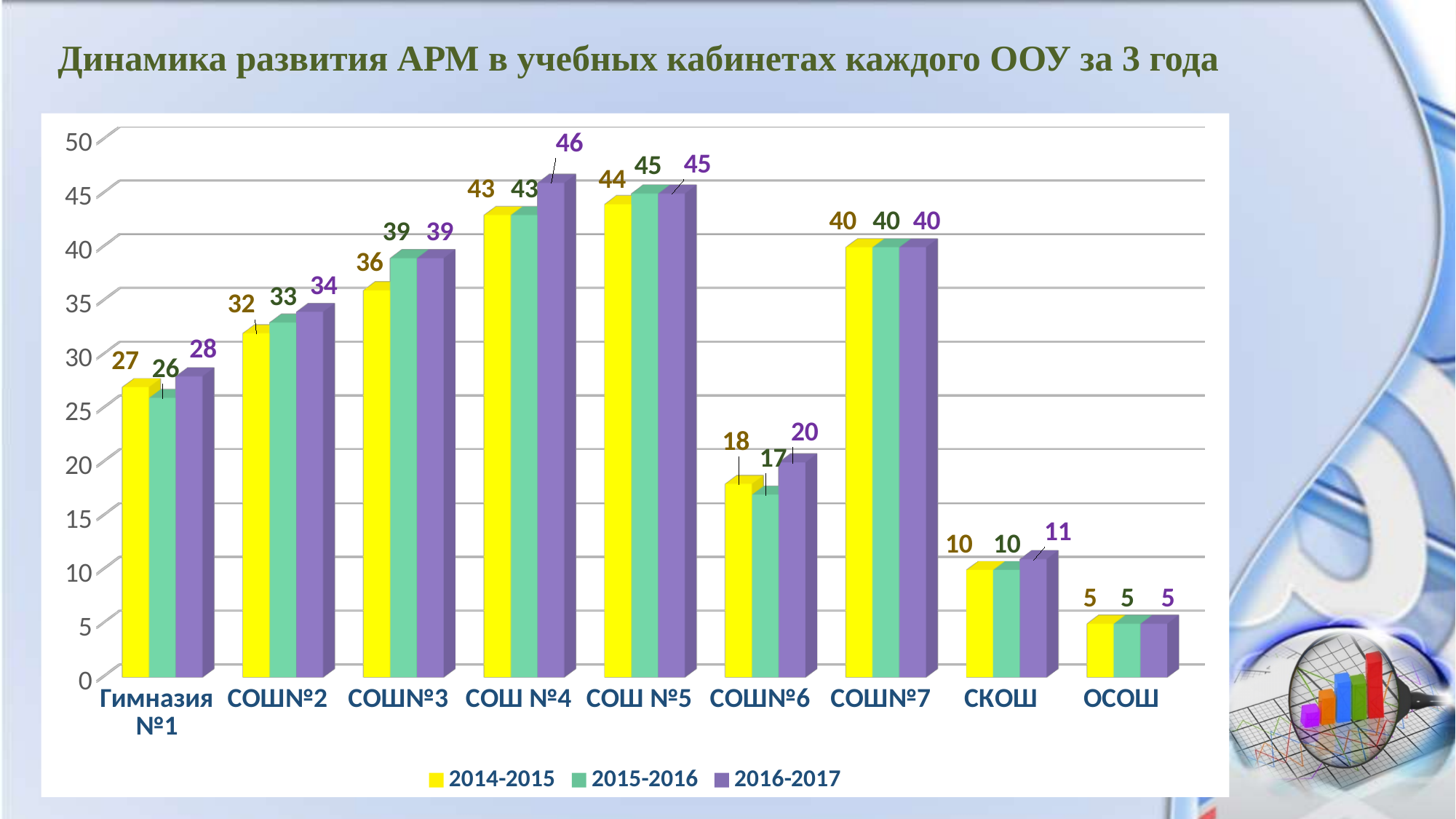
What is the difference between the 2016-2017 and 2014-2015 values for СОШ№3? 3 Which series is shown in yellow in the legend? 2014-2015 What is the value for СОШ№6 in the 2014-2015 series? 18 What kind of chart is shown on the slide? Bar chart What is the value for СОШ №4 in the 2016-2017 series? 46 Do the values for СОШ№2 rise or fall from 2014-2015 to 2016-2017? Rise How many categories are shown on the x axis? 9 How many series does the legend list? 3 Which category has the highest value in the 2016-2017 series? СОШ №4 What is the value for Гимназия №1 in the 2015-2016 series? 26 Which category has the lowest value in the 2014-2015 series? ОСОШ Which is larger: the 2015-2016 value for СОШ №5 or the 2015-2016 value for СОШ №4? СОШ №5